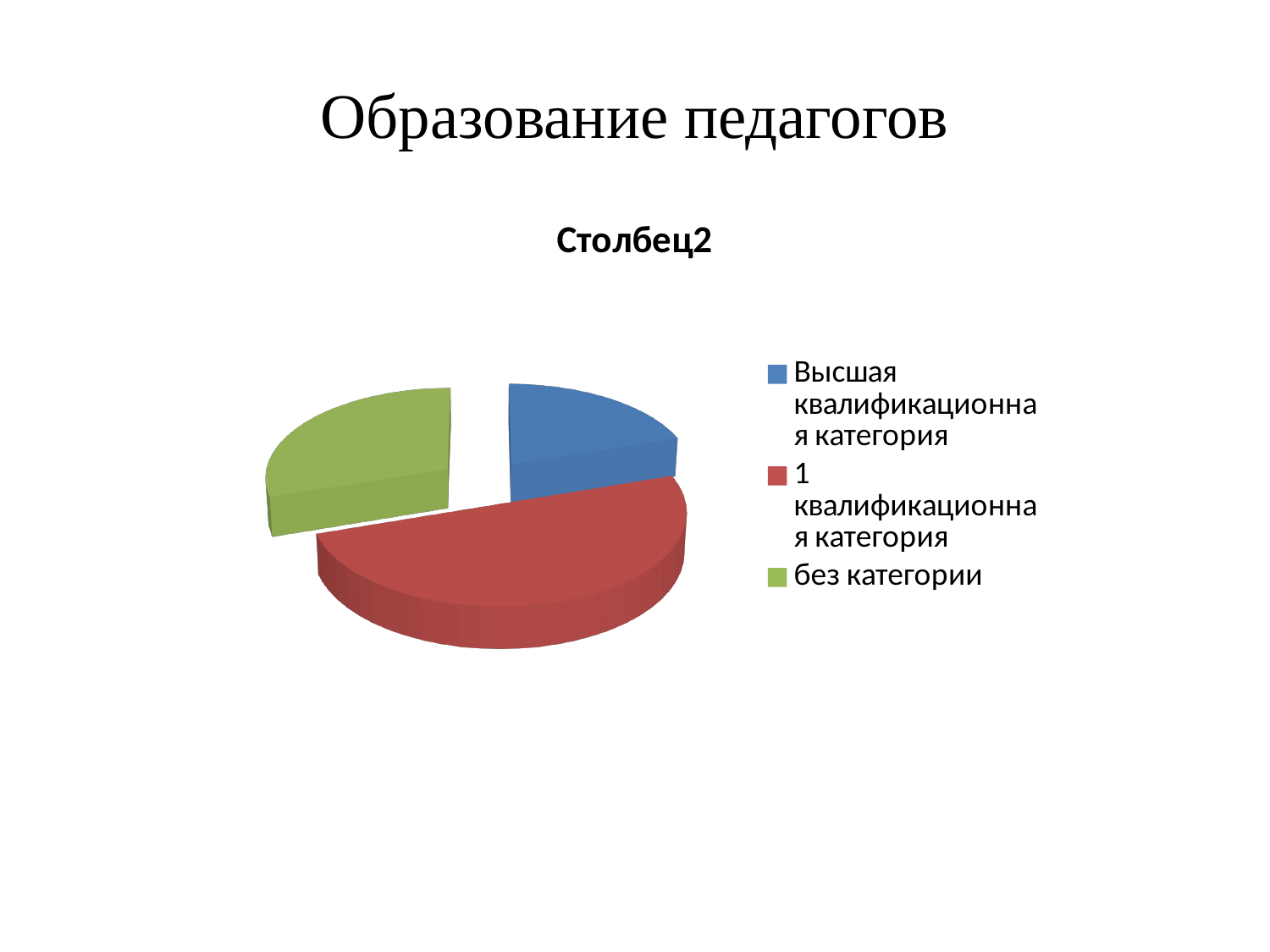
Which category has the largest slice in the pie chart? 1 квалификационная категория Which slice is larger: '1 квалификационная категория' or 'без категории'? 1 квалификационная категория What kind of chart is shown on the slide? pie chart Which category has the smallest slice in the pie chart? Высшая квалификационная категория What is the title of the pie chart? Столбец2 Which slice is larger: 'без категории' or 'Высшая квалификационная категория'? без категории What colour is the slice for 'без категории'? green How many slices does the pie chart have? 3 How many entries does the legend of the pie chart list? 3